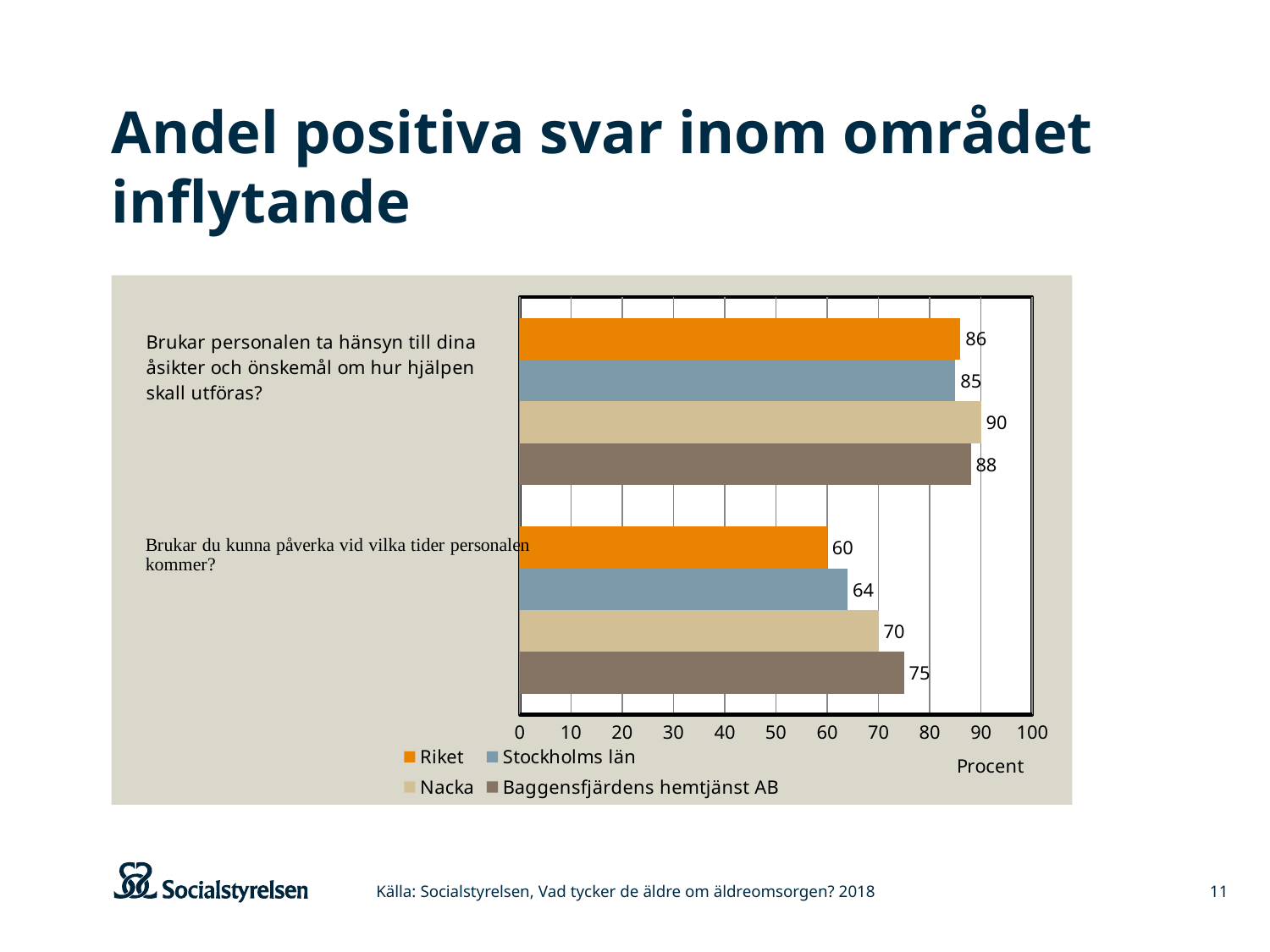
What is the value for Riket on the question "Brukar du kunna påverka vid vilka tider personalen kommer?"? 60 What is the value for Nacka on the question "Brukar personalen ta hänsyn till dina åsikter och önskemål om hur hjälpen skall utföras?"? 90 What is the value for Stockholms län on the question "Brukar personalen ta hänsyn till dina åsikter och önskemål om hur hjälpen skall utföras?"? 85 How many series does the legend list? 4 Which series has the highest value on the question "Brukar du kunna påverka vid vilka tider personalen kommer?"? Baggensfjärdens hemtjänst AB How many questions (categories) are shown on the chart? 2 What type of chart is shown on the slide? bar chart Which is larger on the question "Brukar du kunna påverka vid vilka tider personalen kommer?": Stockholms län or Riket? Stockholms län What is the difference between the Nacka and Riket values on the question "Brukar du kunna påverka vid vilka tider personalen kommer?"? 10 Which series has the lowest value on the question "Brukar personalen ta hänsyn till dina åsikter och önskemål om hur hjälpen skall utföras?"? Stockholms län What is the value for Baggensfjärdens hemtjänst AB on the question "Brukar du kunna påverka vid vilka tider personalen kommer?"? 75 What is the label of the horizontal axis? Procent